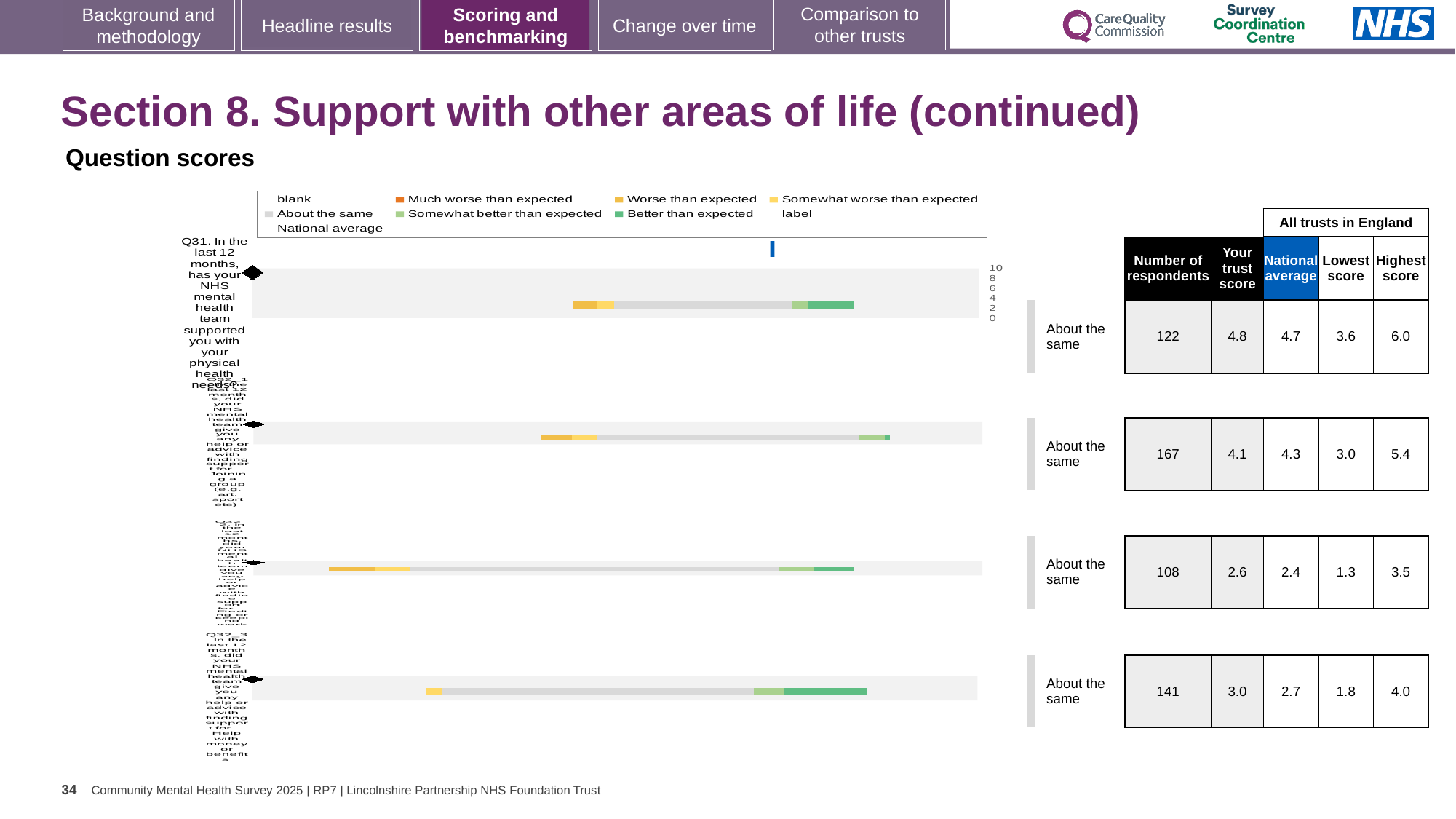
What is the national average for Q31 (support with physical health needs)? 4.7 Which is larger for Q31: the trust score or the national average? trust score How many entries does the chart legend list? 9 What is the difference between the trust score and the national average for Q31? 0.1 How many respondents answered Q31 (support with physical health needs)? 122 How many question bars are plotted in the chart? 4 What kind of chart is used to show the question scores on this slide? bar chart What benchmark category is shown for Q31 (support with physical health needs)? About the same What is the maximum value shown on the chart's score axis? 10 Which of the four question rows has the highest number of respondents? the second row from the top (167) What is the heading printed above the chart? Question scores What is the trust score for Q31 (support with physical health needs)? 4.8